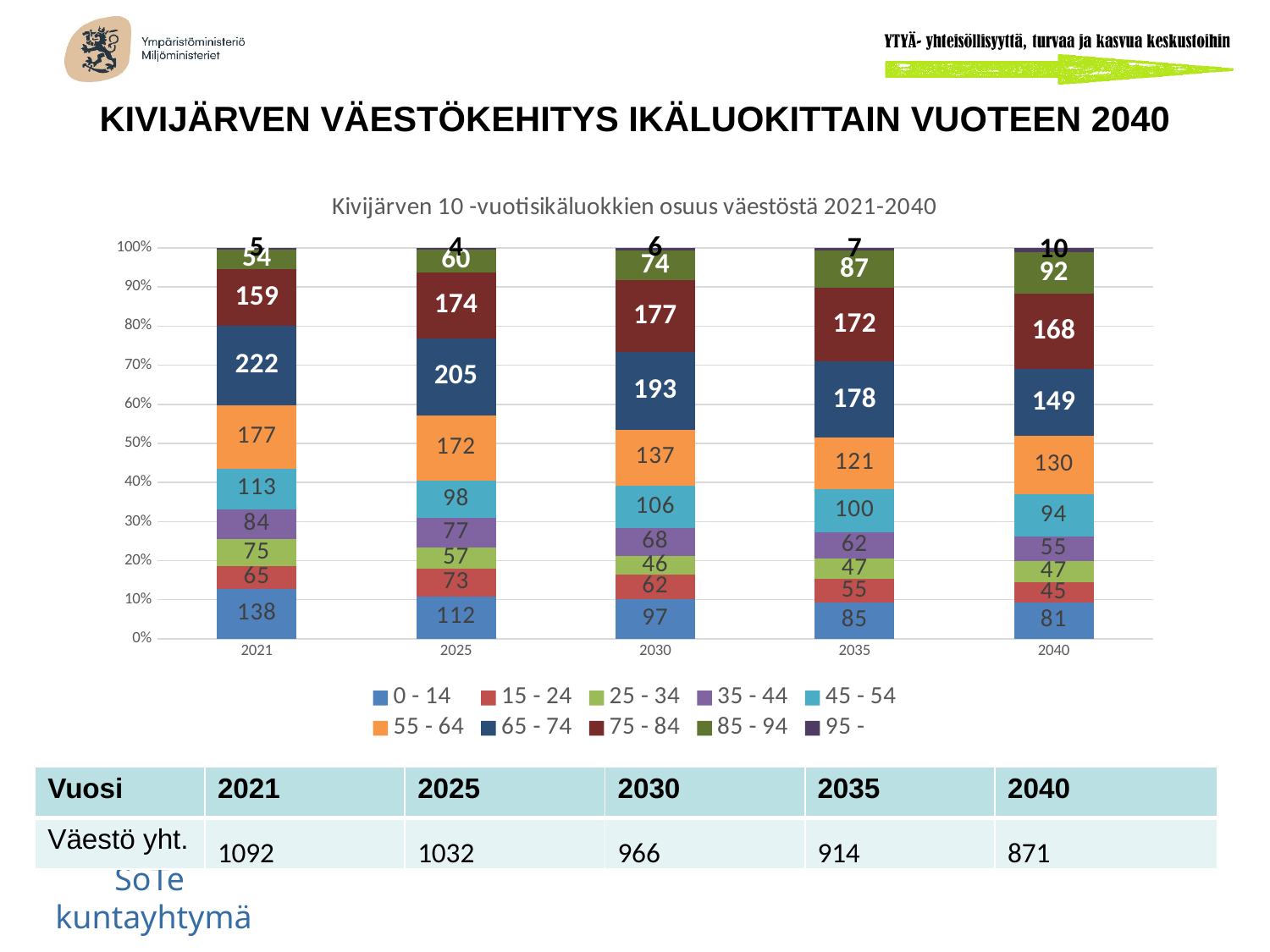
Does the 0 - 14 age group value rise or fall from 2021 to 2040? Fall What is the value for the 0 - 14 age group in 2021? 138 In which year is the 65 - 74 age group value the lowest? 2040 What is the value for the 65 - 74 age group in 2040? 149 How many years are shown on the x axis? 5 What is the value for the 85 - 94 age group in 2035? 87 What kind of chart is shown? Stacked bar chart In which year is the 0 - 14 age group value the highest? 2021 What is the difference between the 65 - 74 values in 2021 and 2040? 73 What is the total of the stacked bar for 2030? 966 How many age groups does the legend list? 10 Which is larger in 2030: the 55 - 64 value or the 45 - 54 value? 55 - 64